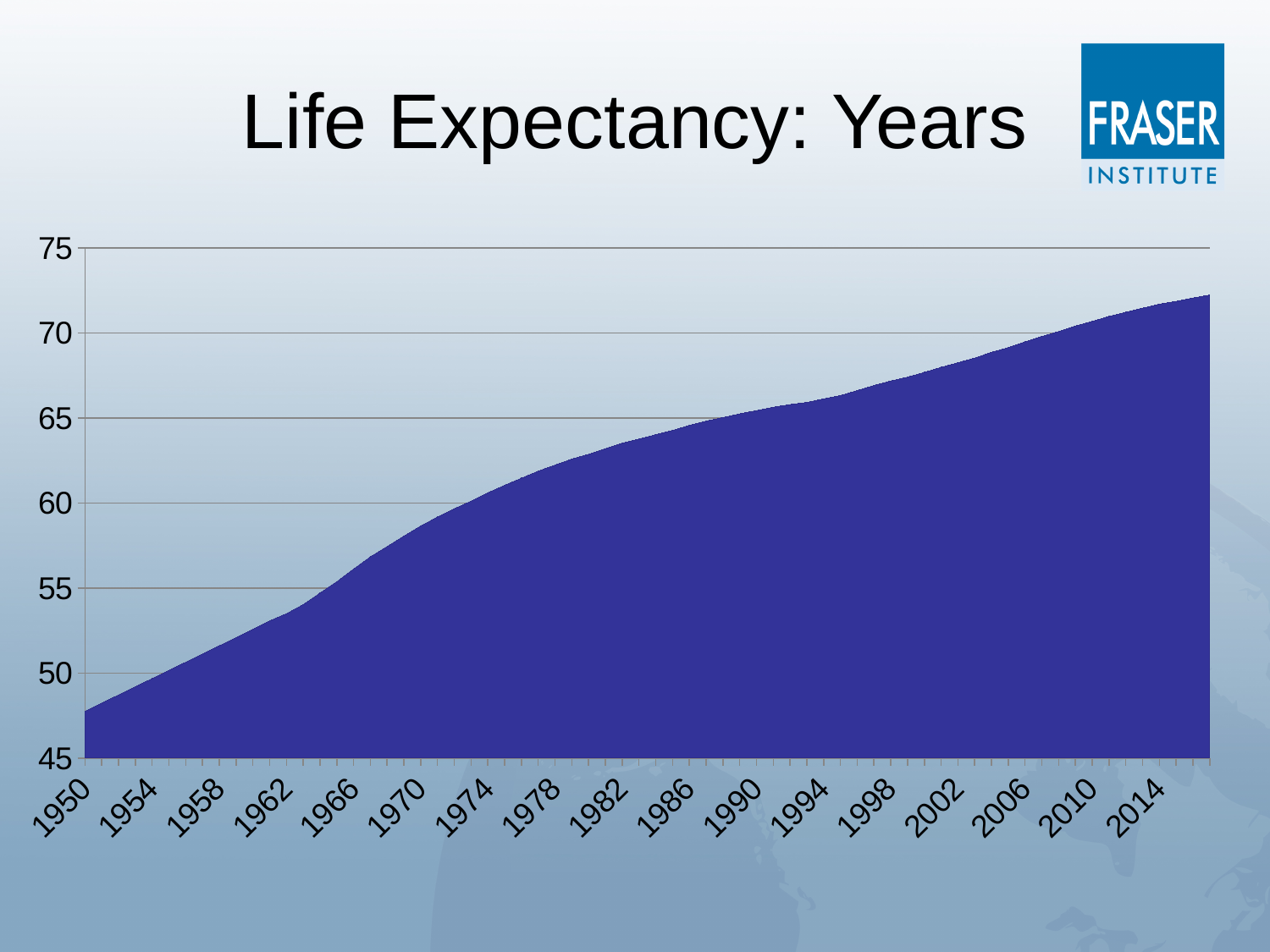
Which is larger, the value for 1966 or the value for 1986? 1986 What is the highest value shown on the vertical axis? 75 What kind of chart is shown on the slide? area chart Is the value for 1970 greater or less than 60? less Do the values rise or fall from 1950 to 2014? rise Is the value for 2002 greater or less than 70? less Is the value for 1982 greater or less than 65? less What is the title of the chart? Life Expectancy: Years Which year has the lowest life expectancy? 1950